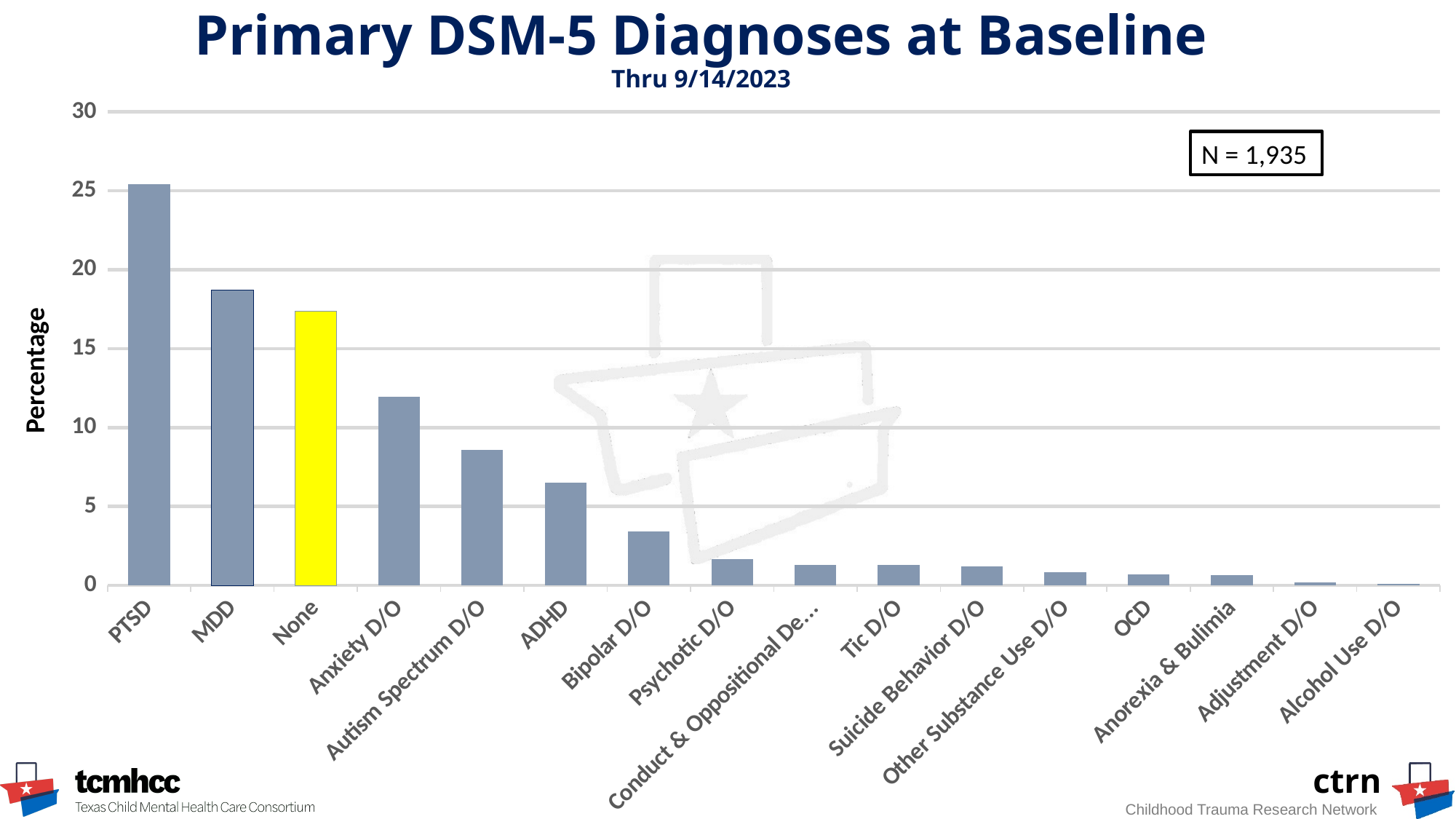
Is the value for None greater or less than 15? greater Which diagnosis category has the highest percentage? PTSD Is the value for MDD greater or less than 20? less How many diagnosis categories are shown on the x axis? 16 What kind of chart is shown on the slide? bar chart Is the value for PTSD greater or less than 20? greater What sample size (N) is shown in the box on the chart? N = 1,935 Which is larger, the value for MDD or the value for None? MDD Do the values rise or fall moving from left to right along the x axis? fall